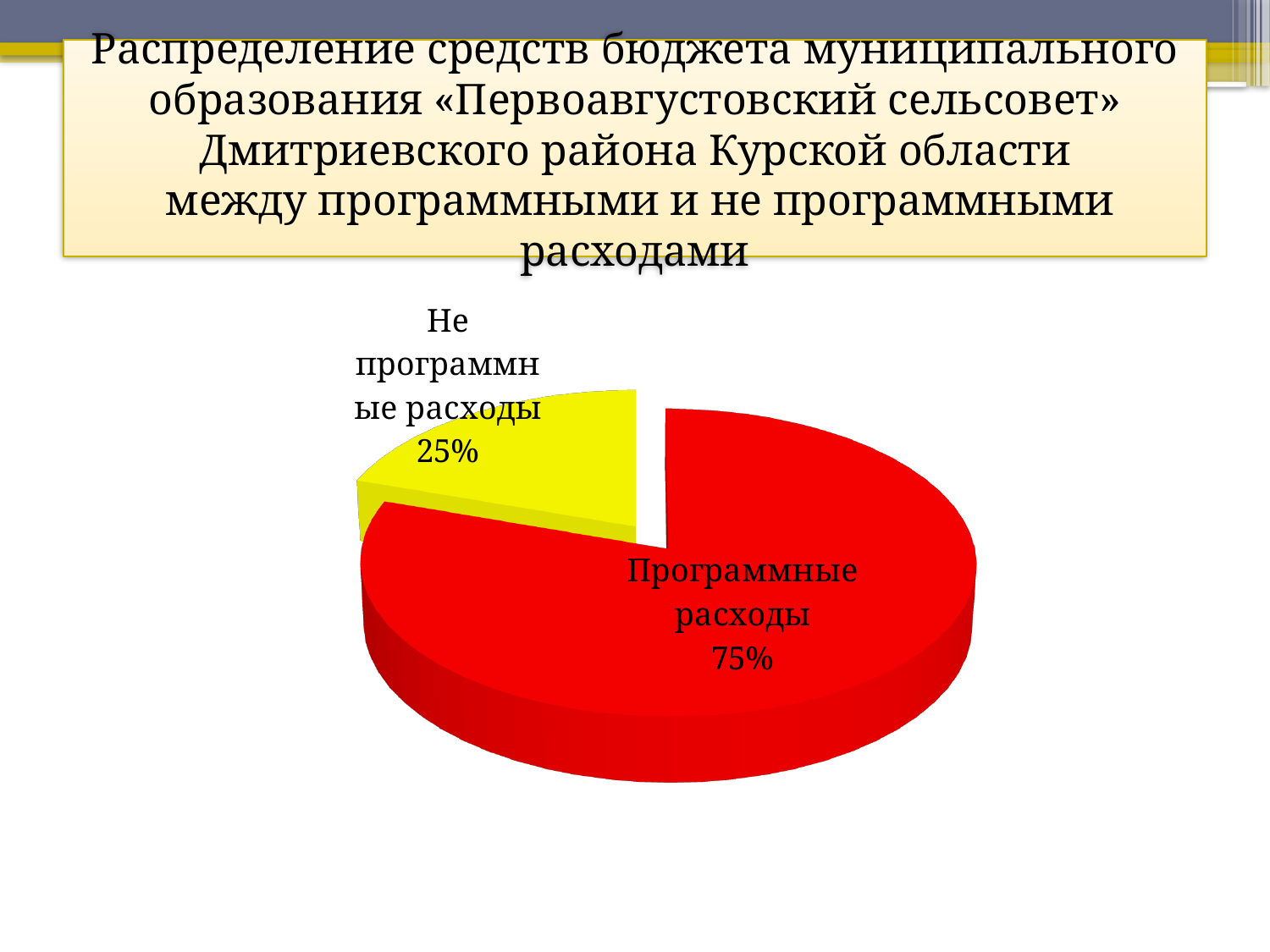
What share of the pie is labelled "Не программные расходы"? 25% What kind of chart is shown on the slide? pie chart Which slice of the pie is the largest? Программные расходы Which slice of the pie is the smallest? Не программные расходы What share of the pie is labelled "Программные расходы"? 75% How many slices does the pie chart have? 2 What colour is the slice for "Не программные расходы"? yellow What is the total of the two slice percentages shown on the pie chart? 100% What is the difference in percentage points between "Программные расходы" and "Не программные расходы"? 50 Which is larger: "Программные расходы" or "Не программные расходы"? Программные расходы What colour is the slice for "Программные расходы"? red